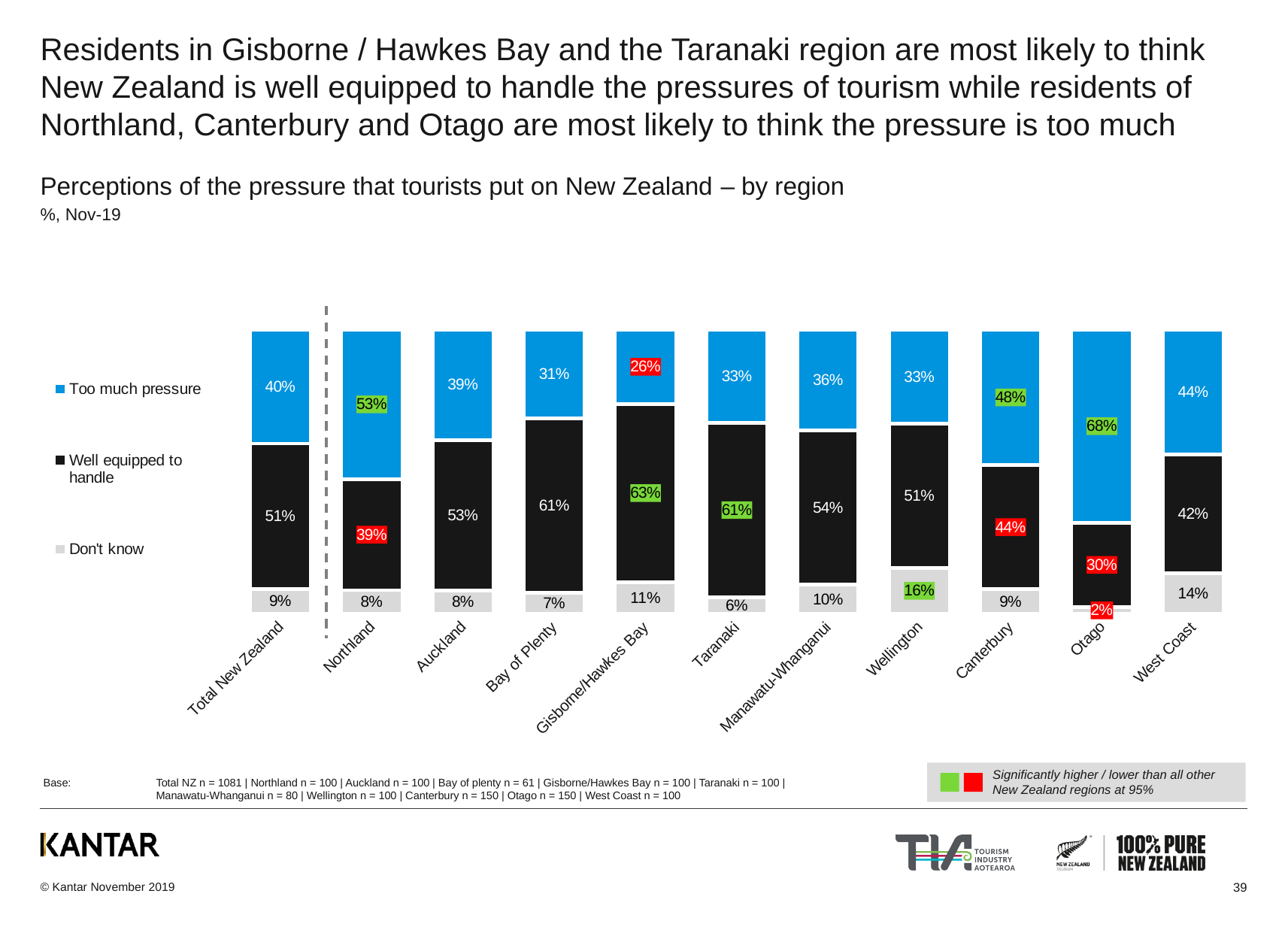
How many categories (bars) are shown on the x axis? 11 Which region has the lowest 'Too much pressure' value? Gisborne/Hawkes Bay Which is larger for Canterbury: 'Too much pressure' or 'Well equipped to handle'? Too much pressure Which region has the highest 'Too much pressure' value? Otago Which region has the lowest 'Don't know' value? Otago How many series does the legend list? 3 What is the 'Don't know' value for Wellington? 16% What is the 'Well equipped to handle' value for Gisborne/Hawkes Bay? 63% What is the difference between the 'Too much pressure' values for Otago and Northland? 15% What percentage of Total New Zealand residents say there is too much pressure? 40% What kind of chart is shown on the slide? Stacked bar chart What is the total of the three segments in the Otago bar? 100%